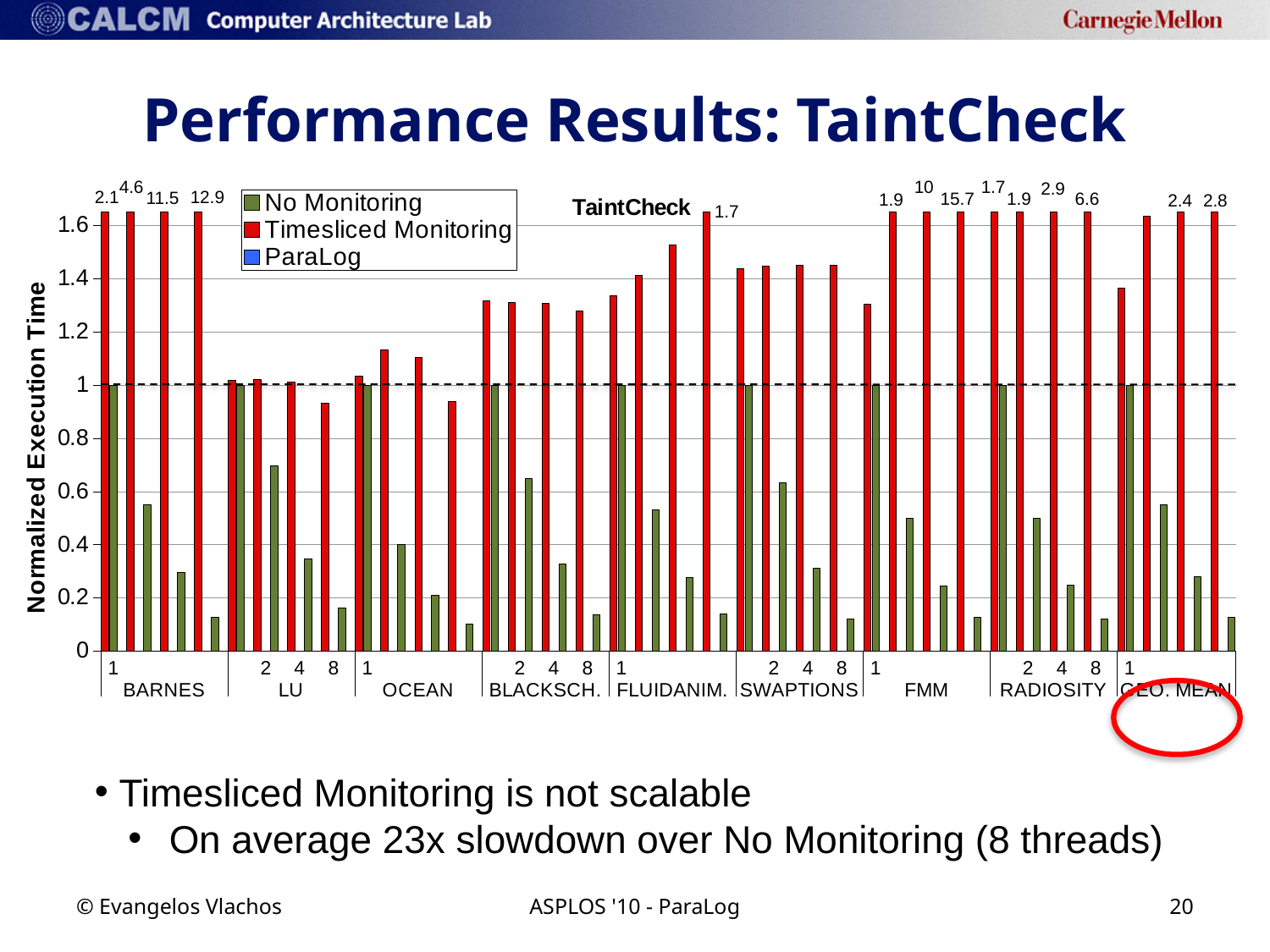
How many series does the legend list? 3 What is the Timesliced Monitoring value for GEO. MEAN at 8 threads? 2.8 What kind of chart is shown on the slide? bar chart Which benchmark has the highest Timesliced Monitoring value at 8 threads? FMM What is the Timesliced Monitoring value for FMM at 8 threads? 15.7 Is the No Monitoring value for BARNES at 8 threads greater or less than 0.2? less What is the Timesliced Monitoring value for BARNES at 8 threads? 12.9 What is the Timesliced Monitoring value for RADIOSITY at 4 threads? 2.9 What is the difference between the Timesliced Monitoring values for BARNES at 8 threads and at 1 thread? 10.8 Within the BARNES group, do the No Monitoring bars rise or fall as the thread count increases from 1 to 8? fall Which is larger at 8 threads: the Timesliced Monitoring value for RADIOSITY or for GEO. MEAN? RADIOSITY How many benchmark groups are shown along the x axis? 9